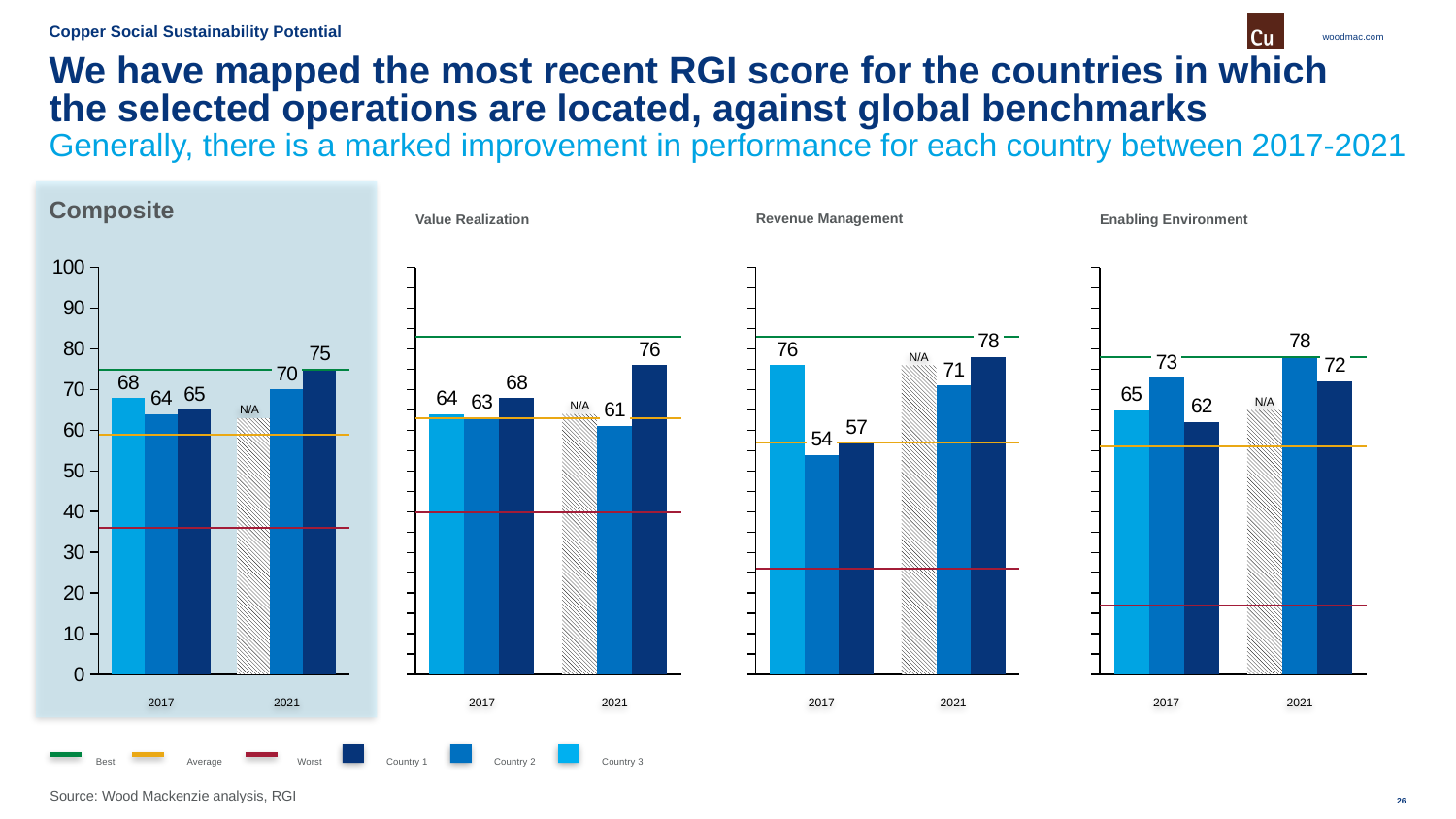
In the Composite chart, what is the value for Country 1 in 2021? 75 In the Revenue Management chart, what is the difference between Country 1's 2021 value and its 2017 value? 21 In the Enabling Environment chart, which country has the highest value in 2017? Country 2 In the Composite chart, which country has the lowest value in 2017? Country 2 In the Composite chart, what is the value for Country 3 in 2017? 68 How many countries does the legend list? 3 In the Value Realization chart, which is larger in 2021: Country 1 or Country 2? Country 1 In the Composite chart, is the value for Country 2 in 2021 greater or less than 60? greater In the Value Realization chart, what is the value for Country 1 in 2021? 76 In the Revenue Management chart, what is the value for Country 2 in 2017? 54 What type of chart is the Composite chart? bar chart In the Enabling Environment chart, what is the value for Country 2 in 2021? 78